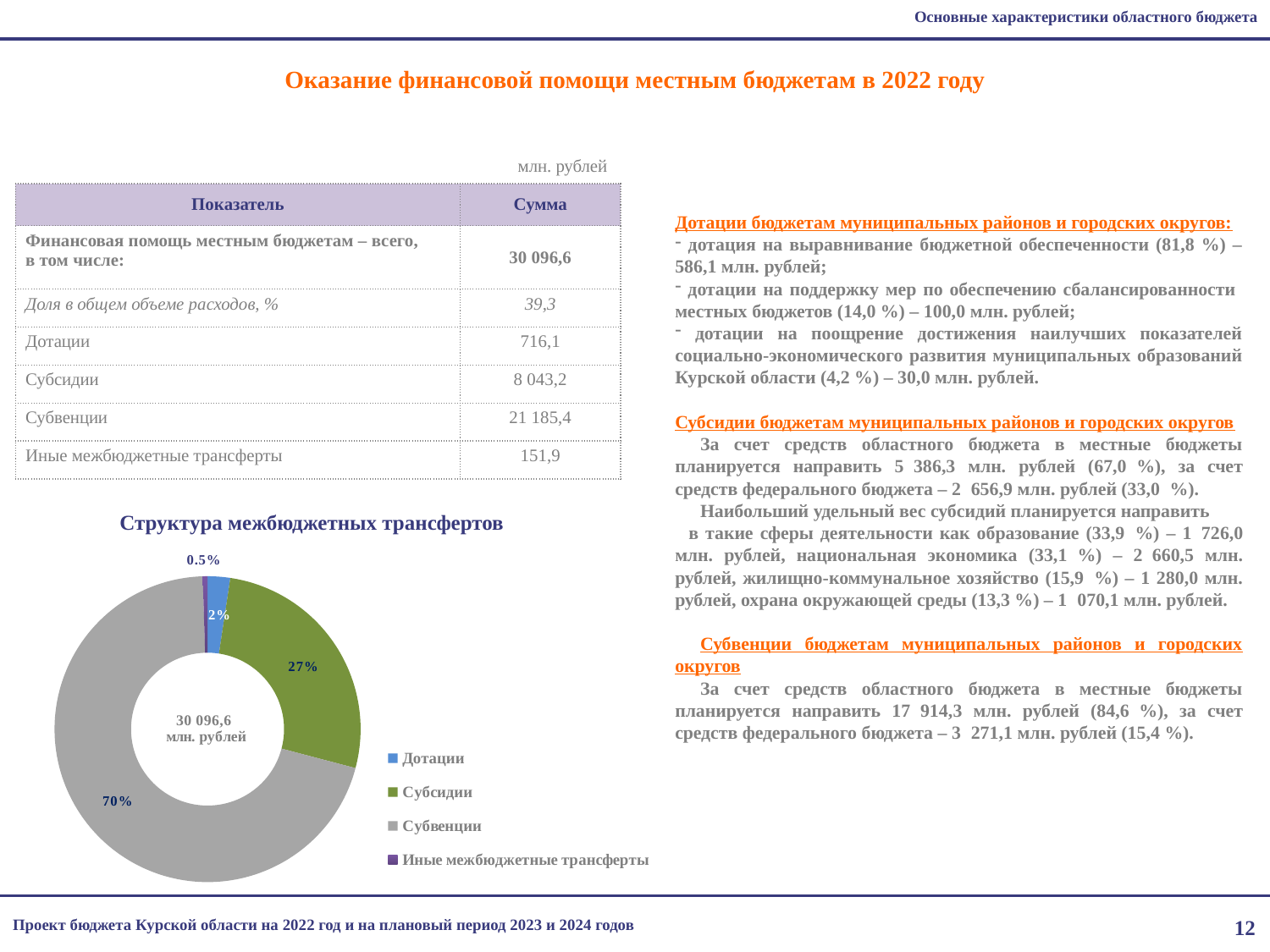
What share of the doughnut chart does Субсидии take? 27% What total value is printed in the centre of the doughnut chart? 30 096,6 млн. рублей Which category has the largest slice in the doughnut chart? Субвенции Which slice is larger in the doughnut chart, Субсидии or Дотации? Субсидии What share of the doughnut chart does Дотации take? 2% What share of the doughnut chart does Субвенции take? 70% What kind of chart is "Структура межбюджетных трансфертов"? Doughnut (pie) chart What is the difference in percentage points between the Субвенции and Субсидии slices? 43 percentage points How many categories does the doughnut chart show? 4 What is the title of the doughnut chart? Структура межбюджетных трансфертов Which category has the smallest slice in the doughnut chart? Иные межбюджетные трансферты